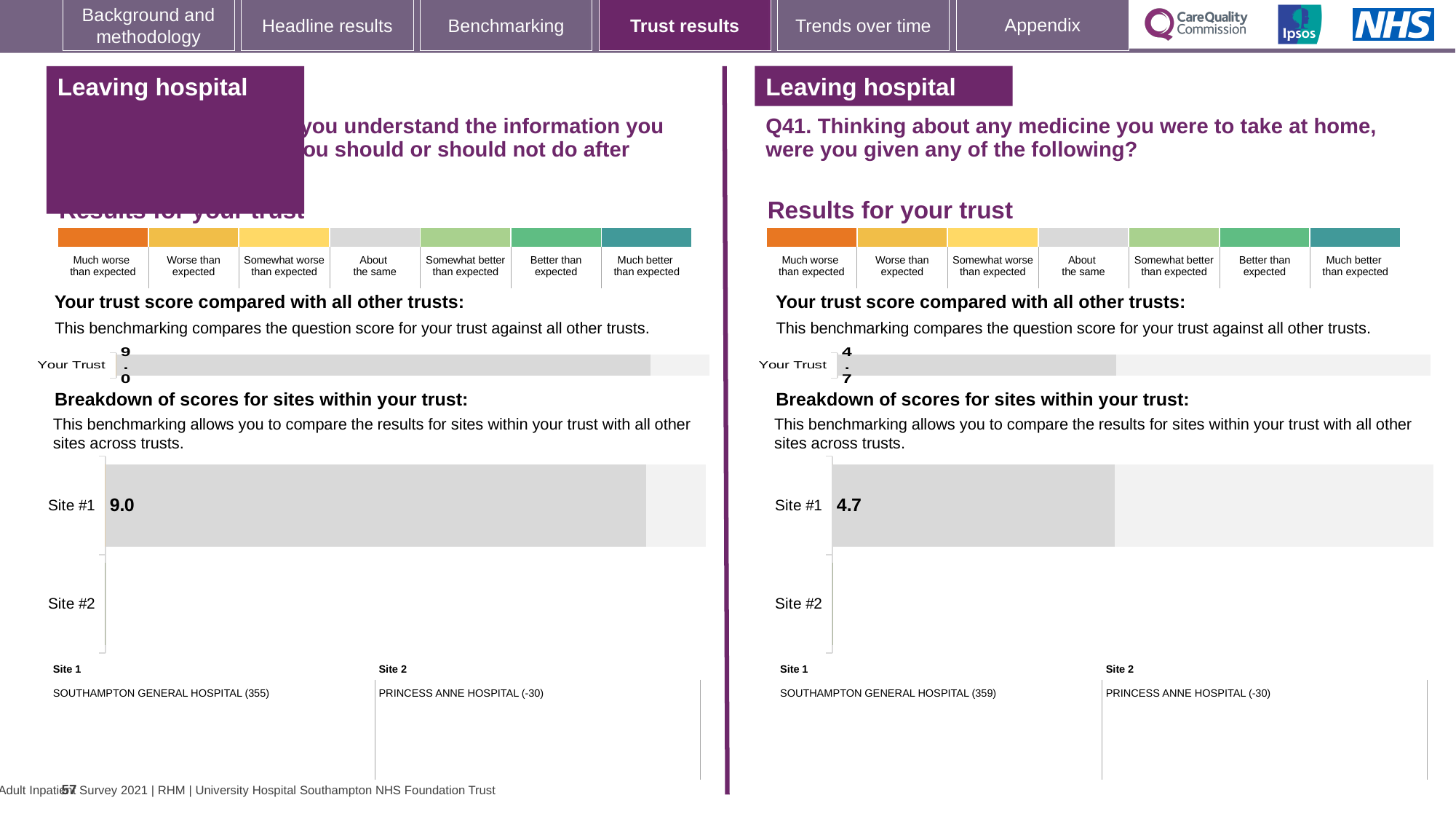
Is the 'Your Trust' score on the right half of the slide (Q41) greater or less than the 'Your Trust' score on the left half? less How many sites are listed in the left 'Breakdown of scores for sites within your trust' chart? 2 On the left half of the slide, what is the 'Your Trust' score shown in the trust benchmarking bar? 9.0 How many sites are listed in the right 'Breakdown of scores for sites within your trust' chart? 2 Which is larger: the Site #1 score in the left breakdown chart or the Site #1 score in the right breakdown chart? Left (9.0) What is the difference between the Site #1 score in the left breakdown chart and the Site #1 score in the right breakdown chart? 4.3 Which hospital is labelled as Site 1 under the right breakdown chart (Q41)? SOUTHAMPTON GENERAL HOSPITAL (359) In the left 'Breakdown of scores for sites within your trust' chart, what is the score for Site #1? 9.0 On the right half of the slide (Q41), what is the 'Your Trust' score shown in the trust benchmarking bar? 4.7 In the left breakdown chart, which site has a bar plotted? Site #1 What type of chart is used for the site breakdown on the right half of the slide? Bar chart In the right 'Breakdown of scores for sites within your trust' chart (Q41), what is the score for Site #1? 4.7